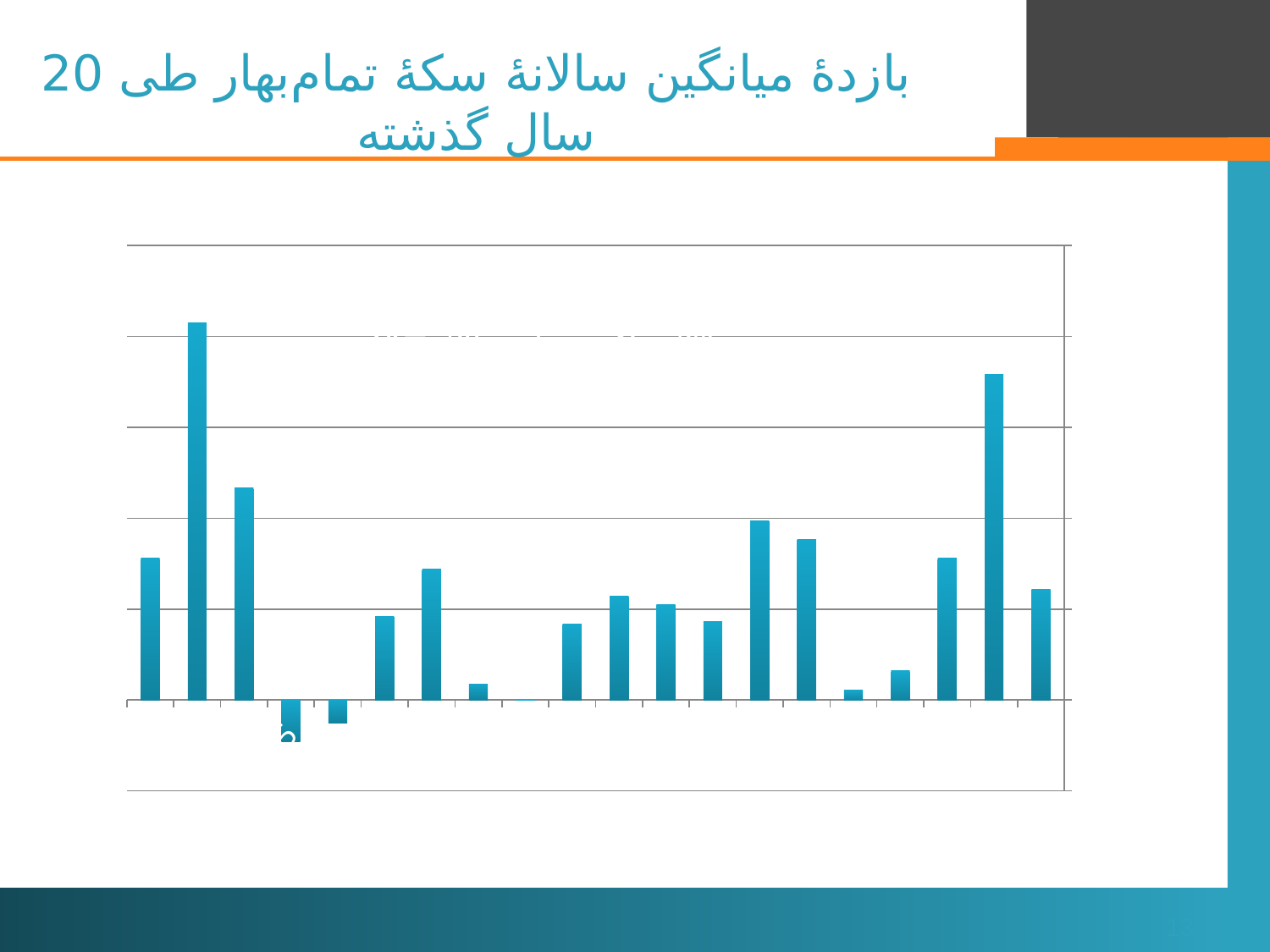
Which bar in the chart extends furthest below the horizontal axis? the fourth bar from the left Is the value of the fourth bar from the left positive or negative? negative What colour are the bars in the chart? blue How many bars in the chart extend below the horizontal axis (negative values)? 2 Which is taller: the third bar from the left or the first bar from the left? the third bar from the left What is the title of the slide containing the chart? بازدۀ میانگین سالانۀ سکۀ تمام‌بهار طی 20 سال گذشته What kind of chart is shown on the slide? bar chart Which bar in the chart is the tallest? the second bar from the left Which is taller: the second bar from the left or the second bar from the right? the second bar from the left